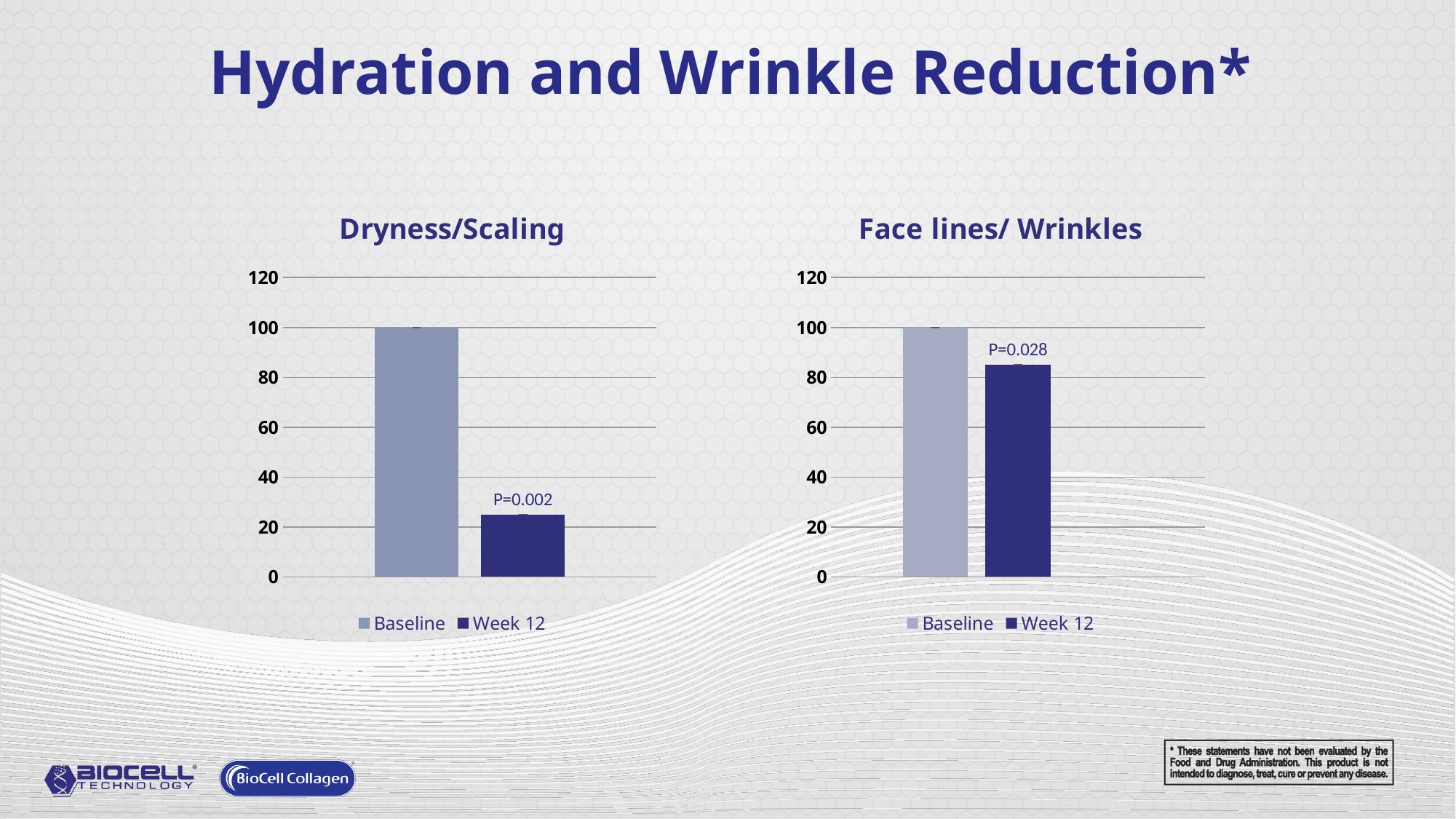
In the Face lines/ Wrinkles chart, which series has the lowest value? Week 12 What kind of chart is the Dryness/Scaling chart? bar chart In the Dryness/Scaling chart, which is larger, Baseline or Week 12? Baseline In the Face lines/ Wrinkles chart, what P value label is shown above the Week 12 bar? P=0.028 In the Face lines/ Wrinkles chart, what is the value for Baseline? 100 In the Dryness/Scaling chart, what P value label is shown above the Week 12 bar? P=0.002 In the Dryness/Scaling chart, what is the value for Baseline? 100 In the Face lines/ Wrinkles chart, is the value for Week 12 greater or less than 80? greater In the Dryness/Scaling chart, do the values rise or fall from Baseline to Week 12? fall In the Dryness/Scaling chart, how many series does the legend list? 2 In the Face lines/ Wrinkles chart, is the value for Week 12 greater or less than 100? less In the Dryness/Scaling chart, is the value for Week 12 greater or less than 40? less